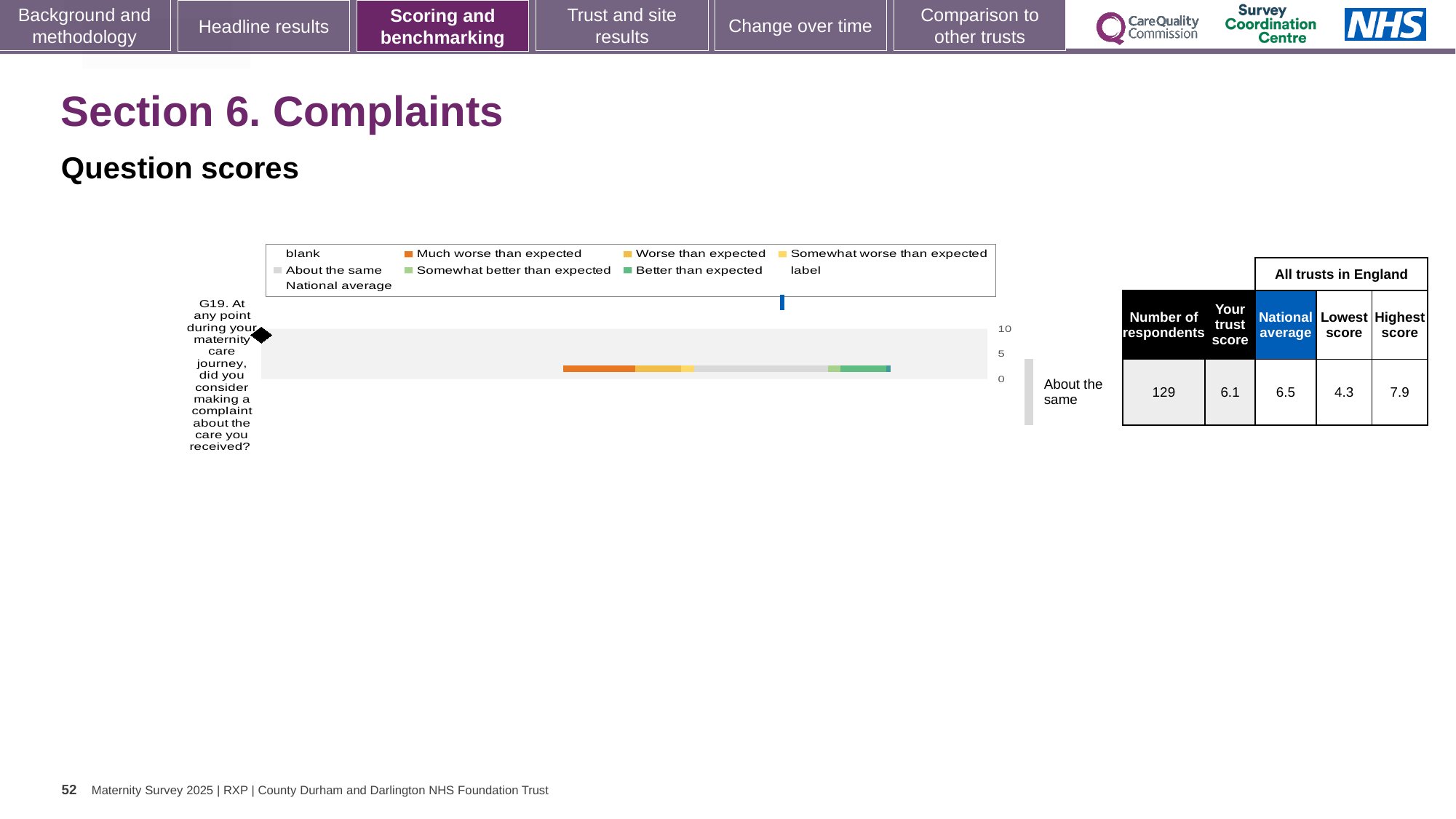
How many survey questions are plotted in the chart? 1 What kind of chart is shown on the slide for question G19? bar chart How many entries does the chart legend list? 9 According to the table beside the chart, what is the lowest score among all trusts in England for question G19? 4.3 Which is larger for question G19: the trust score or the national average? national average According to the table beside the chart, what is the highest score among all trusts in England for question G19? 7.9 According to the table beside the chart, how many respondents answered question G19? 129 What is the difference between the highest score and the lowest score for question G19? 3.6 What colour does the legend use for 'Much worse than expected'? orange According to the table beside the chart, what is the national average score for question G19? 6.5 What is the highest tick value shown on the chart's score axis? 10 According to the table beside the chart, what is the trust score for question G19? 6.1